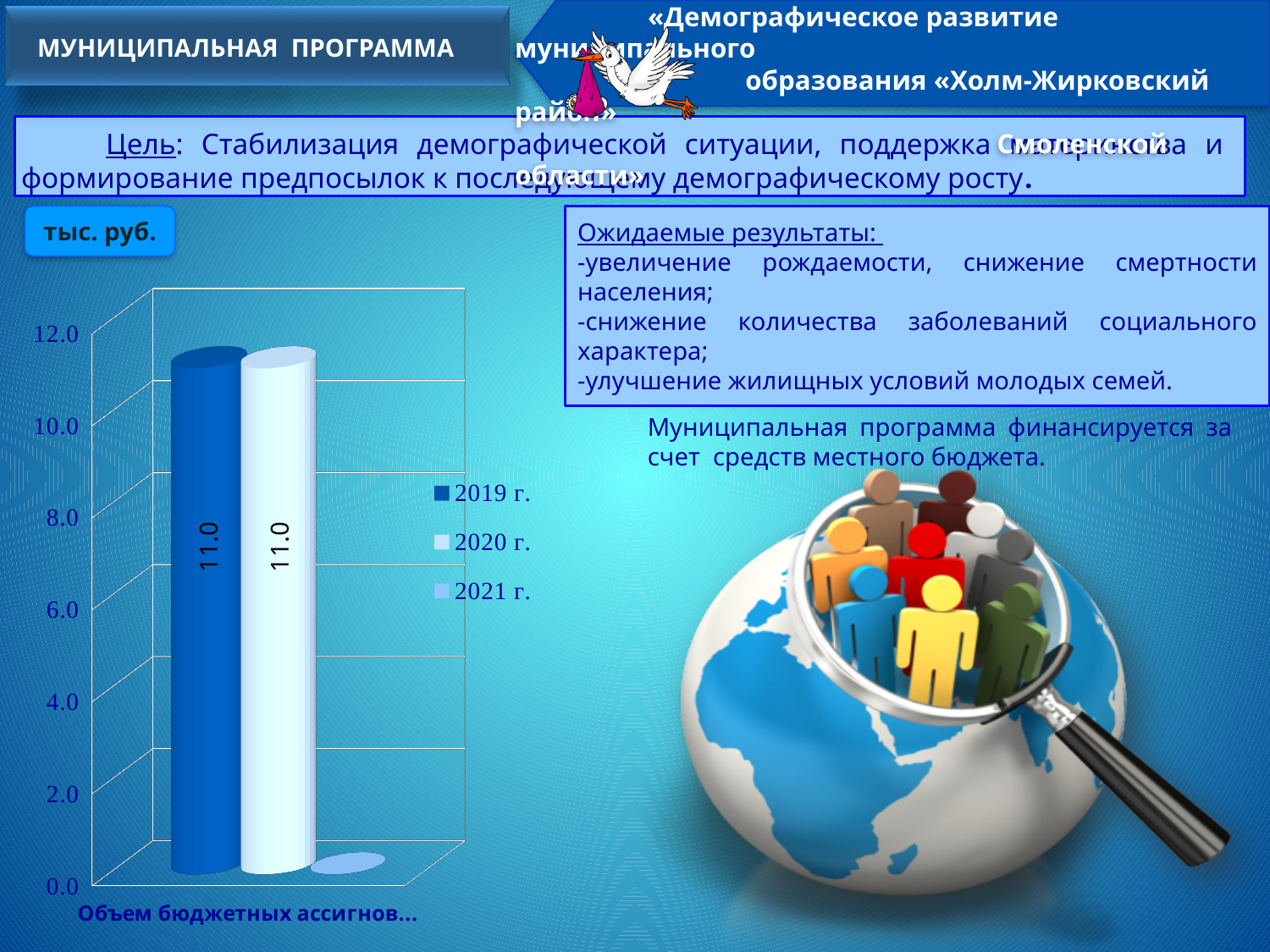
Which series has the lowest value in the chart? 2021 г. Which is larger, the 2019 г. value or the 2020 г. value? They are equal How many series does the chart legend list? 3 What unit is indicated for the chart values? тыс. руб. Is the value for 2019 г. greater or less than 10.0? greater What is the value of the 2020 г. bar in the chart? 11.0 Is the value for 2021 г. greater or less than 2.0? less How many categories are shown on the x axis of the chart? 1 What is the difference between the 2019 г. and 2020 г. values? 0.0 What is the value of the 2019 г. bar in the chart? 11.0 What is the highest tick value shown on the vertical axis? 12.0 What kind of chart is shown on the slide? bar chart